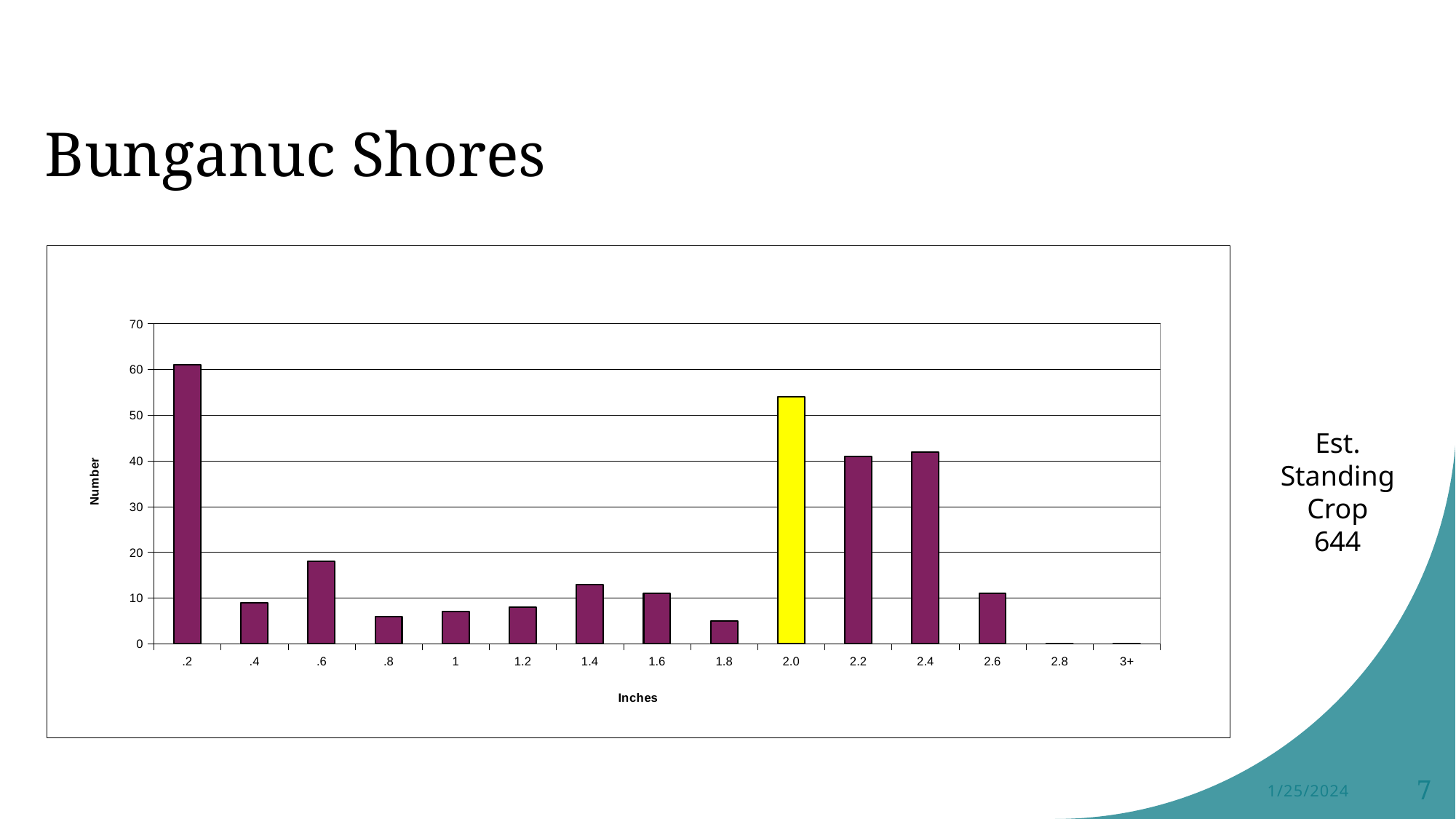
What is the label of the x axis of the chart? Inches Is the value for .2 greater or less than 50? greater Which has a larger value, .2 or 2.0? .2 Which category has the highest value in the chart? .2 What kind of chart is shown on the slide? bar chart How many categories are shown on the x axis of the chart? 15 Is the value for 2.0 greater or less than 50? greater Is the value for 1.4 greater or less than 10? greater Which category's bar is coloured yellow in the chart? 2.0 Which has a larger value, .4 or .6? .6